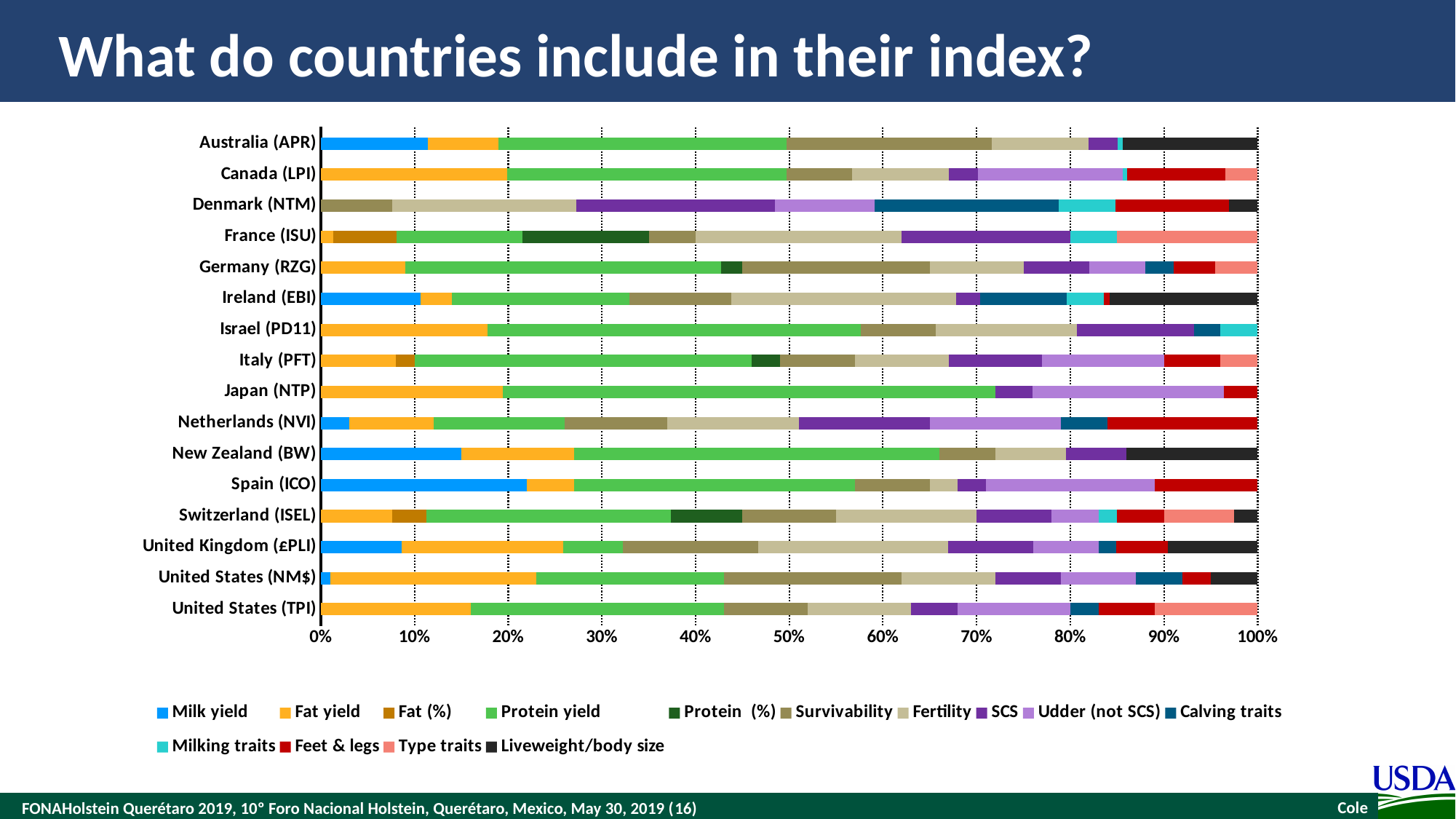
How many series does the legend list? 14 Which country has a larger Protein yield share, Japan (NTP) or Netherlands (NVI)? Japan (NTP) Which country has the largest Protein yield share in its index? Japan (NTP) How many countries (categories) are listed on the chart? 16 Which colour represents Protein yield in the chart? Green Is the Milk yield share for Australia (APR) greater or less than 10%? greater Is the Milk yield share for Spain (ICO) greater or less than 20%? greater Which country has a larger Milk yield share, Spain (ICO) or Australia (APR)? Spain (ICO) Is the Calving traits share for Denmark (NTM) greater or less than 10%? greater What is the title of the slide? What do countries include in their index? What kind of chart is shown on the slide? Stacked bar chart